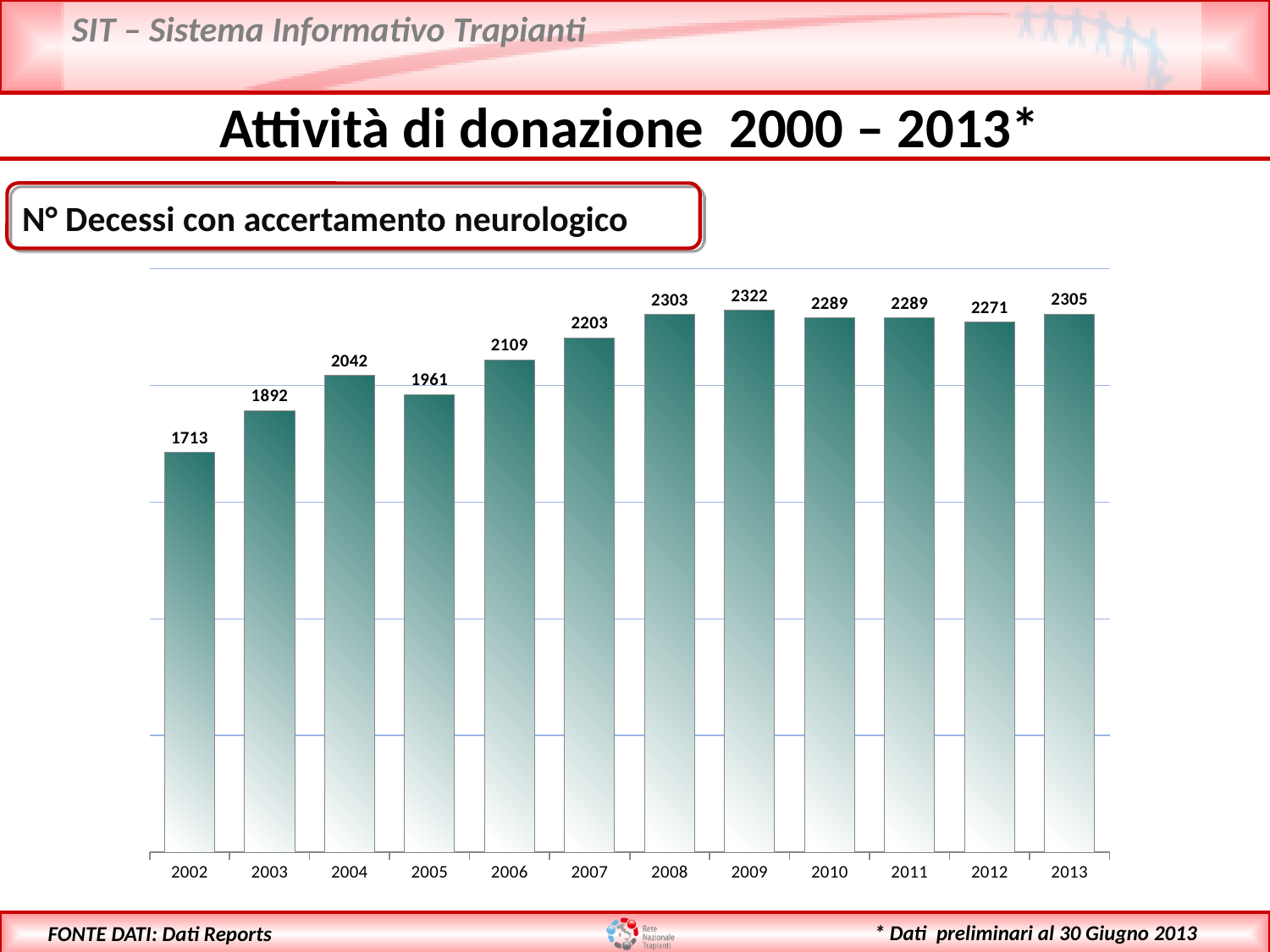
What is the value for 2005? 1961 How many years are shown on the x axis? 12 Which year has the lowest value? 2002 Which is larger, the value for 2006 or the value for 2007? 2007 What is the value for 2002? 1713 Which year has the highest value? 2009 What is the difference between the values for 2013 and 2002? 592 What is the value for 2009? 2322 What is the difference between the values for 2004 and 2005? 81 What is the value for 2013? 2305 What is the title shown in the box above the chart? N° Decessi con accertamento neurologico What kind of chart is shown on the slide? Bar chart